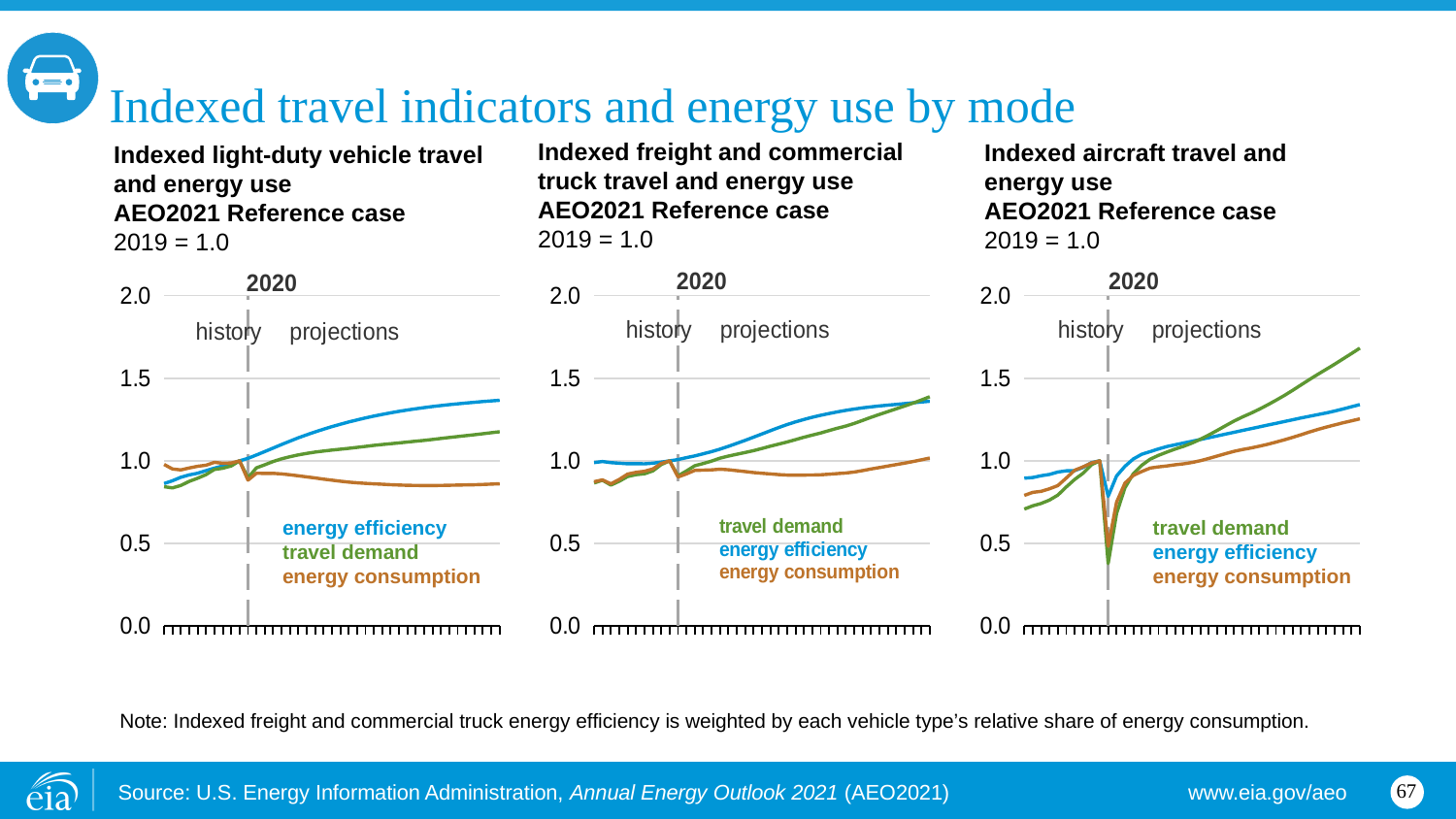
What year does the vertical dashed line in each chart mark as the boundary between history and projections? 2020 How many charts are shown on the slide? 3 What kind of chart is the 'Indexed light-duty vehicle travel and energy use' chart? line chart In the 'Indexed aircraft travel and energy use' chart, is the travel demand value at the end of the projections greater or less than 1.5? greater How many series are plotted in the 'Indexed aircraft travel and energy use' chart? 3 In the 'Indexed light-duty vehicle travel and energy use' chart, is the energy efficiency value at the end of the projections greater or less than 1.0? greater In the 'Indexed aircraft travel and energy use' chart, does the travel demand line rise or fall over the projection period? rise In the 'Indexed light-duty vehicle travel and energy use' chart, does the energy consumption line rise or fall over the projection period? fall In the 'Indexed light-duty vehicle travel and energy use' chart, is the energy consumption value at the end of the projections greater or less than 1.0? less In the 'Indexed light-duty vehicle travel and energy use' chart, which is larger at the end of the projections: energy efficiency or energy consumption? energy efficiency In the 'Indexed aircraft travel and energy use' chart, which series has the highest value at the end of the projections? travel demand